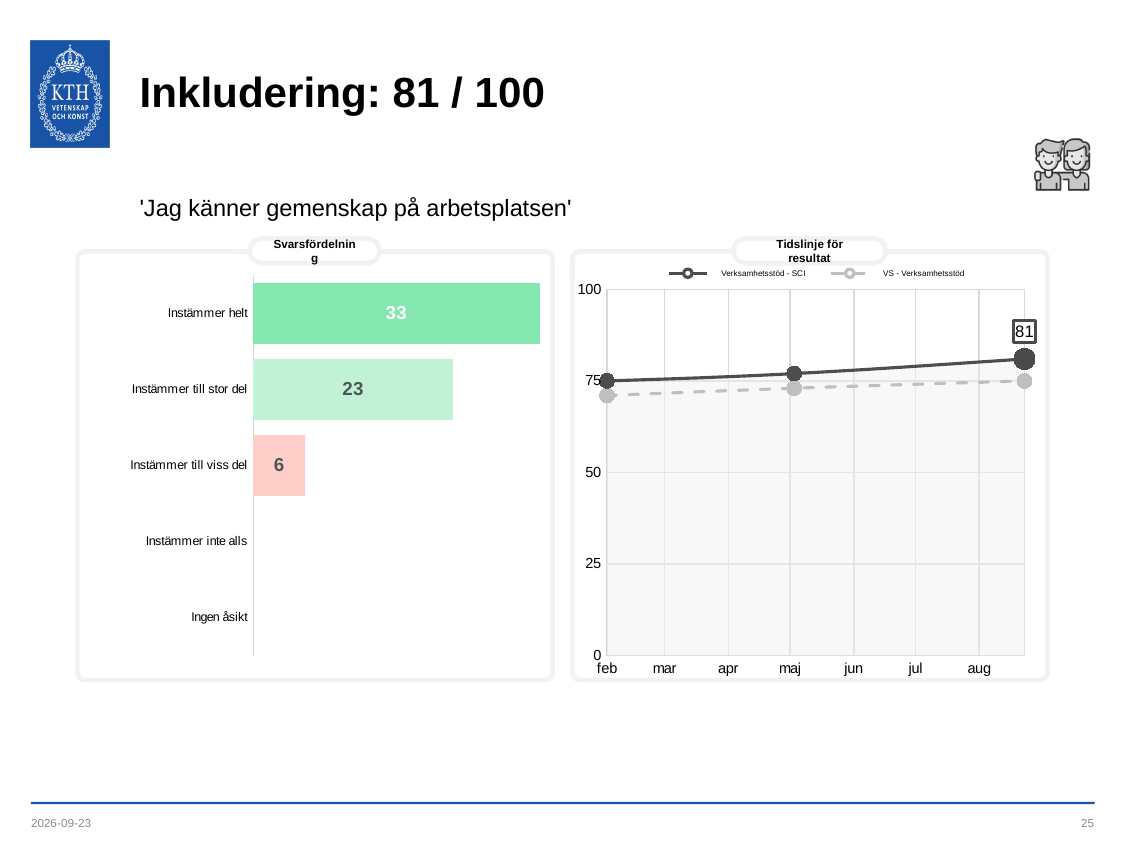
In the 'Svarsfördelning' chart, what is the value for 'Instämmer helt'? 33 In the 'Svarsfördelning' chart, which category has the highest value? Instämmer helt In the 'Svarsfördelning' chart, what is the difference between 'Instämmer helt' and 'Instämmer till stor del'? 10 In the 'Svarsfördelning' chart, which is larger: 'Instämmer till stor del' or 'Instämmer till viss del'? Instämmer till stor del How many categories are listed on the y axis of the 'Svarsfördelning' chart? 5 In the 'Svarsfördelning' chart, what is the value for 'Instämmer till viss del'? 6 What kind of chart is the 'Svarsfördelning' chart? bar chart How many series does the legend of the 'Tidslinje för resultat' chart list? 2 In the 'Tidslinje för resultat' chart, does the 'Verksamhetsstöd - SCI' line rise or fall from feb to aug? rise In the 'Tidslinje för resultat' chart, is the value for 'VS - Verksamhetsstöd' in feb greater or less than 75? less In the 'Svarsfördelning' chart, what is the value for 'Instämmer till stor del'? 23 In the 'Tidslinje för resultat' chart, what is the labelled value for 'Verksamhetsstöd - SCI' in aug? 81